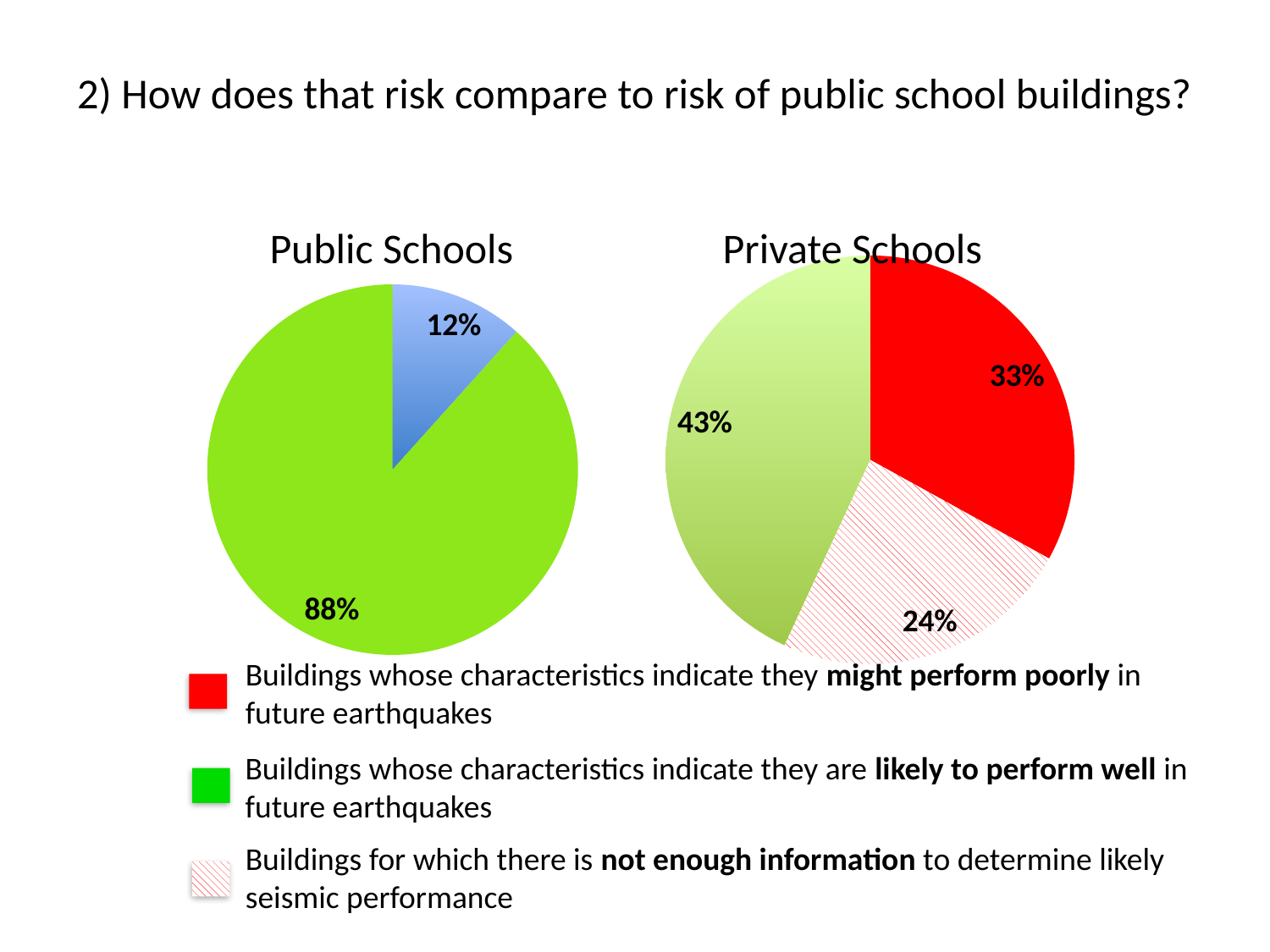
In the Private Schools pie chart, which category has the largest share? Likely to perform well (43%) In the Public Schools pie chart, what percentage is shown for the green slice? 88% What is the difference between the 'likely to perform well' share in the Public Schools chart (88%) and in the Private Schools chart (43%)? 45 percentage points Which is larger: the 'might perform poorly' share in the Private Schools chart or the 'not enough information' share in the Private Schools chart? Might perform poorly (33%) In the Private Schools pie chart, what percentage of buildings have not enough information to determine likely seismic performance (hatched slice)? 24% In the Private Schools pie chart, what percentage of buildings might perform poorly in future earthquakes (red slice)? 33% What kind of charts are shown on the slide? Pie charts In the Private Schools pie chart, what percentage of buildings are likely to perform well in future earthquakes (green slice)? 43% How many slices does the Public Schools pie chart have? 2 In the Private Schools pie chart, which category has the smallest share? Not enough information (24%) In the Public Schools pie chart, what percentage is shown for the blue slice? 12% How many slices does the Private Schools pie chart have? 3